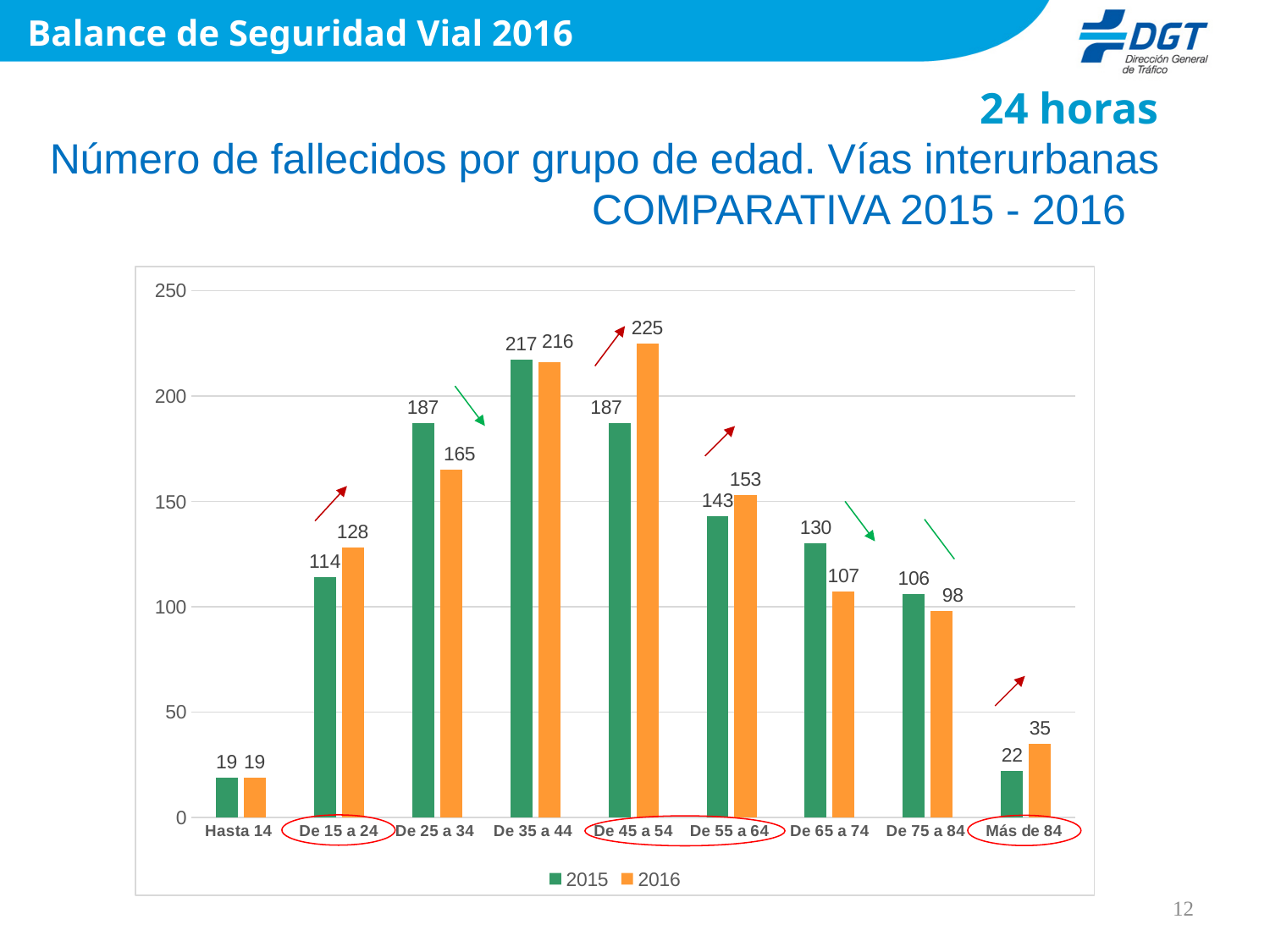
What is the value for 2016 in the 'De 45 a 54' age group? 225 Which is larger for the 'De 55 a 64' age group, the 2015 value or the 2016 value? 2016 Which age group has the lowest value for 2016? Hasta 14 What is the value for 2016 in the 'Más de 84' age group? 35 What kind of chart is shown on the slide? bar chart What is the difference between the 2015 and 2016 values for the 'De 25 a 34' age group? 22 Is the 2016 value for 'De 65 a 74' greater or less than 150? less Which colour represents the 2016 series in the chart? orange How many series does the legend list? 2 Which age group has the highest value for 2015? De 35 a 44 What is the value for 2015 in the 'De 25 a 34' age group? 187 How many age groups are shown on the x axis? 9